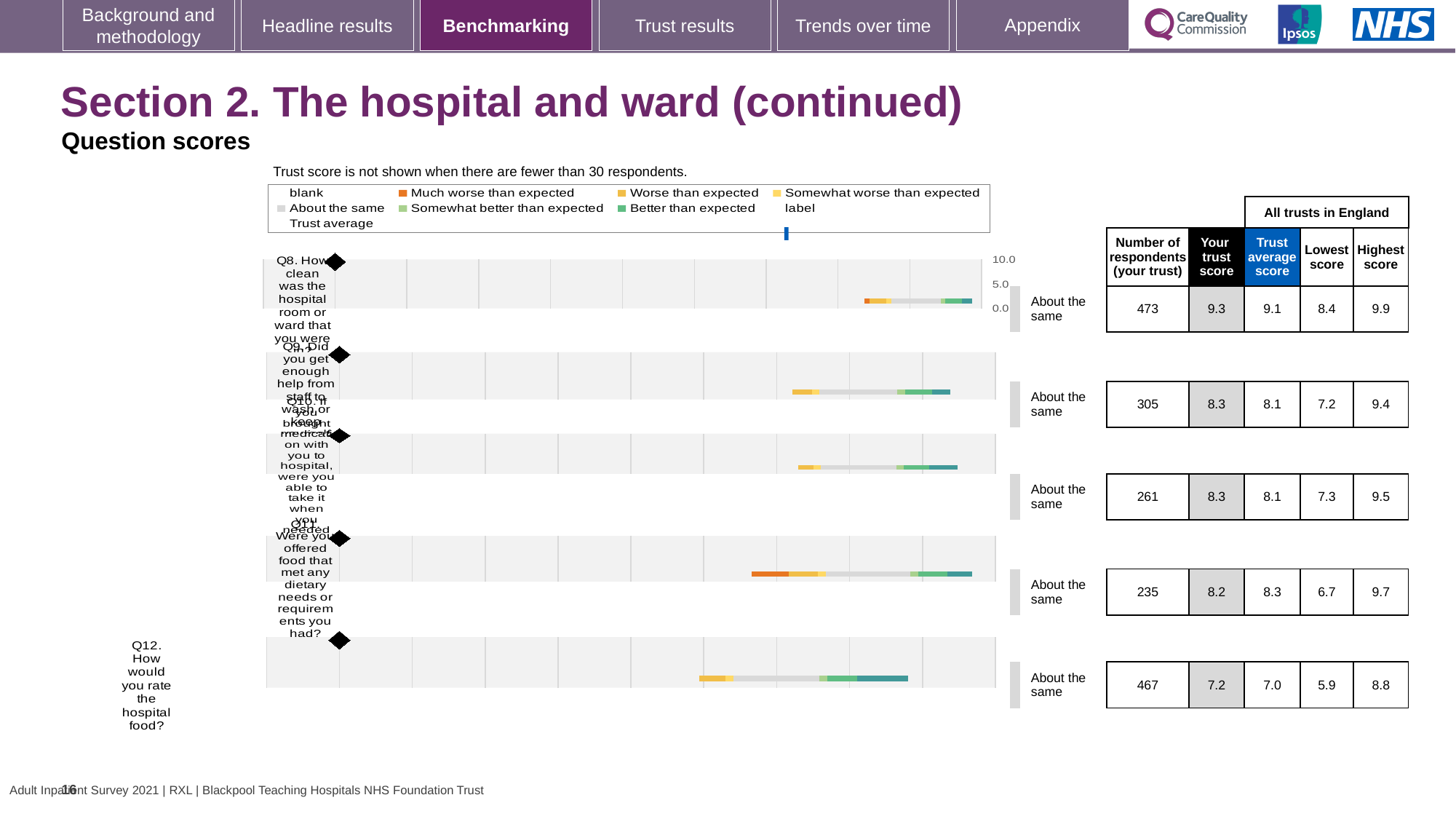
How many respondents answered Q12 (How would you rate the hospital food?) at this trust? 467 What benchmark category is shown for Q10 (If you brought medication with you to hospital, were you able to take it when you needed to?)? About the same For Q11, which is larger: this trust's score or the trust average score? Trust average score What is the trust score for Q8 (How clean was the hospital room or ward that you were in?)? 9.3 Which question has the lowest trust score for this trust? Q12 What is the difference between the highest score (9.9) and the lowest score (8.4) for Q8? 1.5 What kind of chart is used to show the question scores? Bar chart What is the trust average score across all trusts in England for Q9 (Did you get enough help from staff to wash or keep yourself clean?)? 8.1 Which question has the highest trust score for this trust? Q8 What is the highest score among all trusts in England for Q11 (Were you offered food that met any dietary needs or requirements you had?)? 9.7 What is the lowest score among all trusts in England for Q12 (How would you rate the hospital food?)? 5.9 How many questions are plotted on the chart? 5